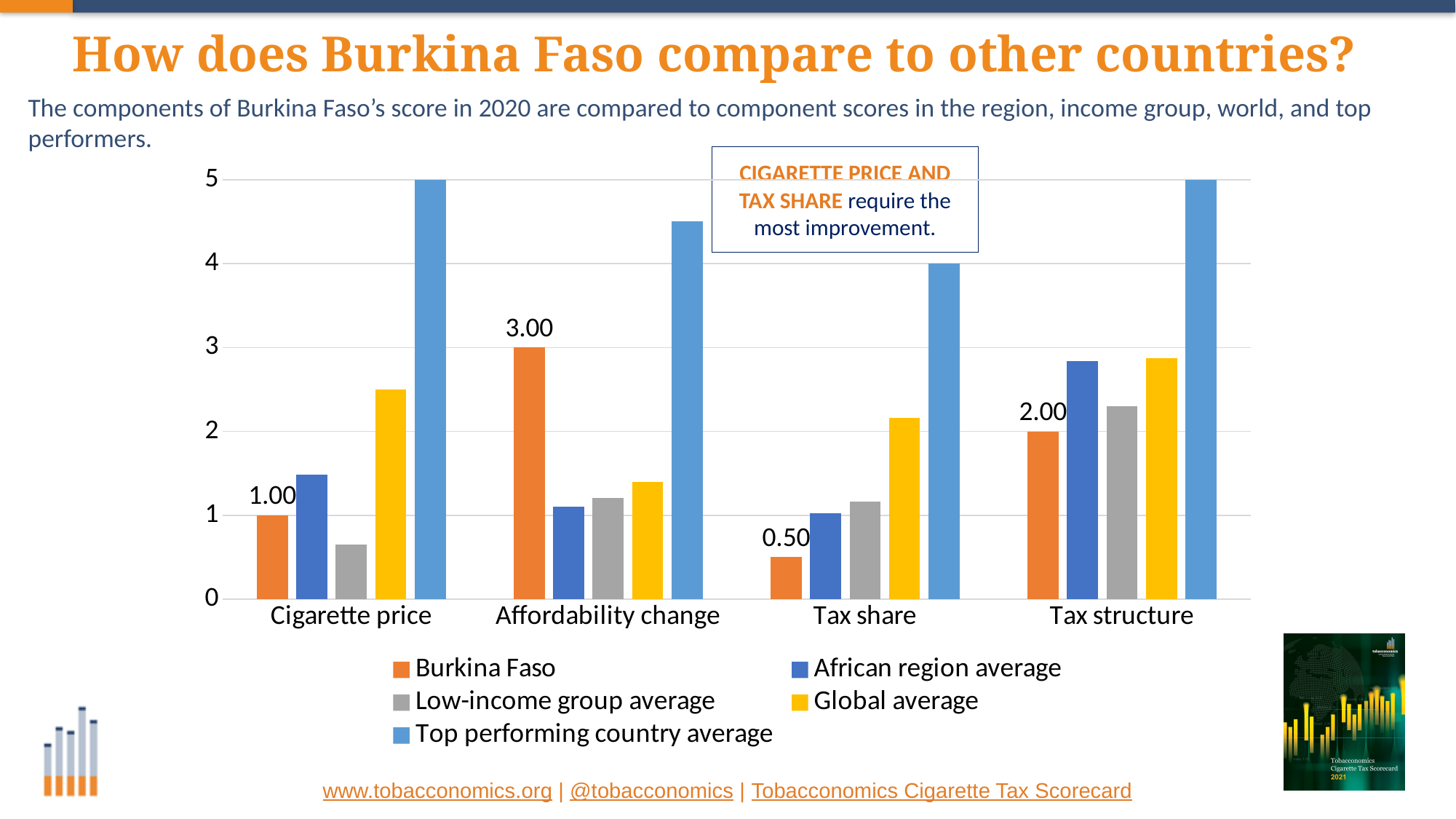
Which is larger for Burkina Faso: the Tax structure score or the Cigarette price score? Tax structure In which category does Burkina Faso have its lowest score? Tax share What is the value for Burkina Faso in the Affordability change category? 3.00 Is the Low-income group average for Cigarette price greater or less than 1? less What kind of chart is shown on the slide? Bar chart What is the value for Burkina Faso in the Cigarette price category? 1.00 How many categories are shown on the x axis of the chart? 4 Is the Top performing country average for Affordability change greater or less than 4? greater How many series does the legend list? 5 What is the difference between Burkina Faso's Affordability change score and its Cigarette price score? 2.00 What is the value for Burkina Faso in the Tax share category? 0.50 In which category does Burkina Faso have its highest score? Affordability change